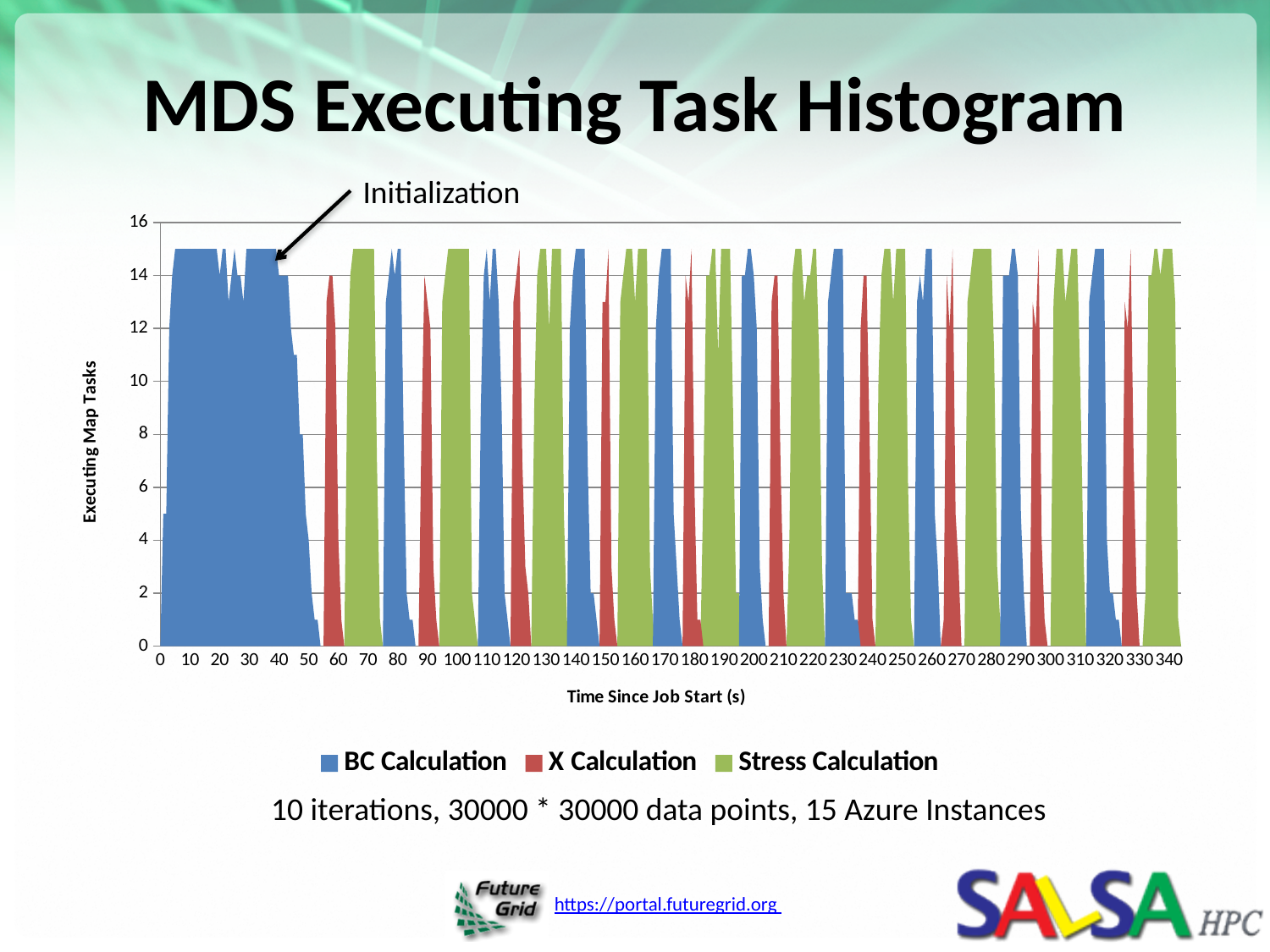
What kind of chart is shown on the slide? area chart What is the highest tick value shown on the vertical axis? 16 What is the label of the vertical axis? Executing Map Tasks Is the value for BC Calculation at time 10 s greater or less than 12? greater What is the highest tick value shown on the horizontal axis? 340 Is the peak value for Stress Calculation near time 70 s greater or less than 14? greater Is the value for X Calculation at time 100 s greater or less than 2? less How many series does the legend list? 3 What is the title of the chart? MDS Executing Task Histogram